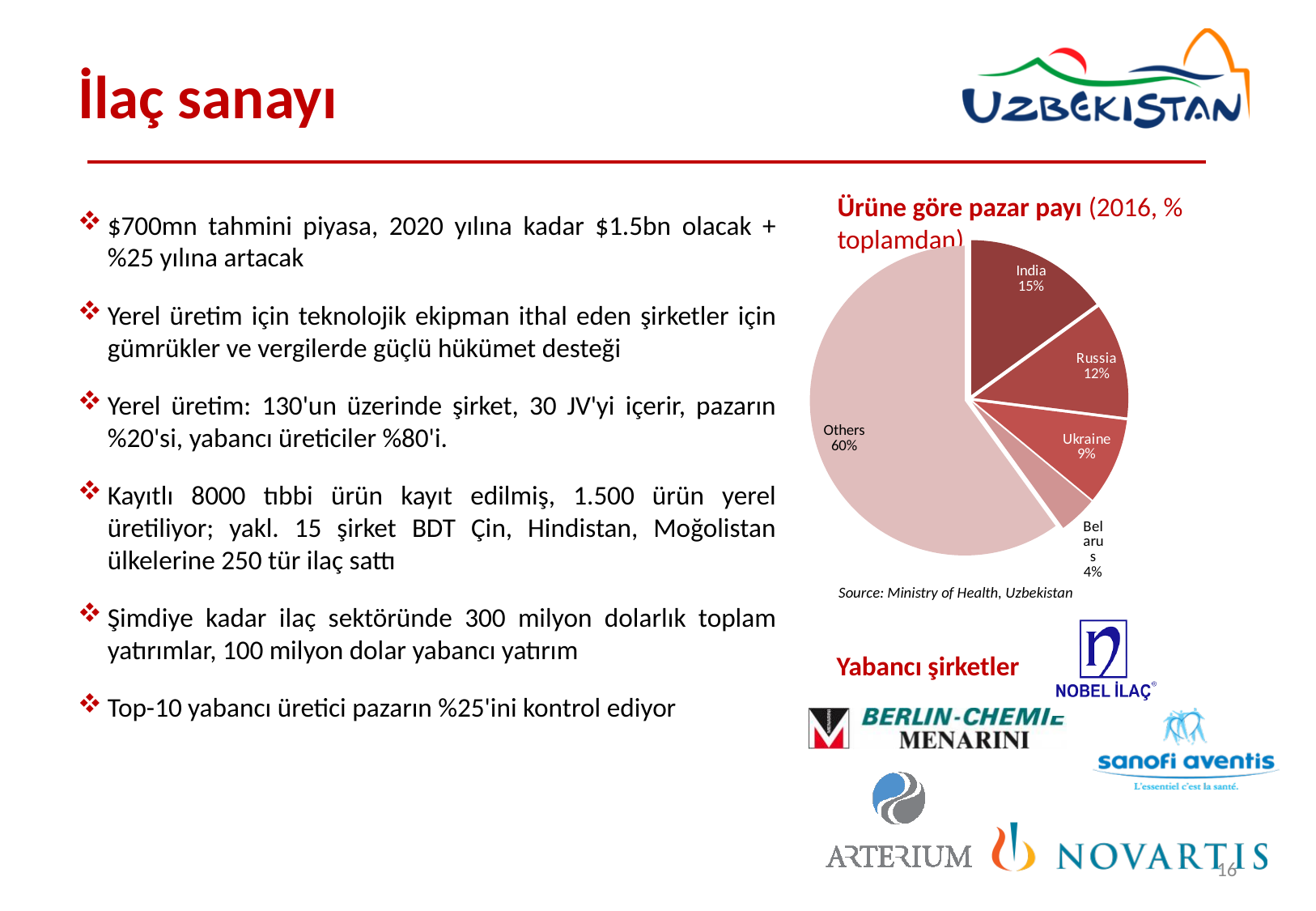
What is the market share for Belarus in the pie chart? 4% What is the market share for Russia in the pie chart? 12% What is the market share for Others in the pie chart? 60% What is the difference in market share between India and Russia? 3% What is the market share for India in the pie chart? 15% How many slices does the pie chart have? 5 Which slice of the pie chart is the smallest? Belarus What is the market share for Ukraine in the pie chart? 9% Which has a larger market share, Ukraine or Belarus? Ukraine What source is cited below the pie chart? Ministry of Health, Uzbekistan Which slice of the pie chart is the largest? Others What type of chart is shown on the slide? pie chart